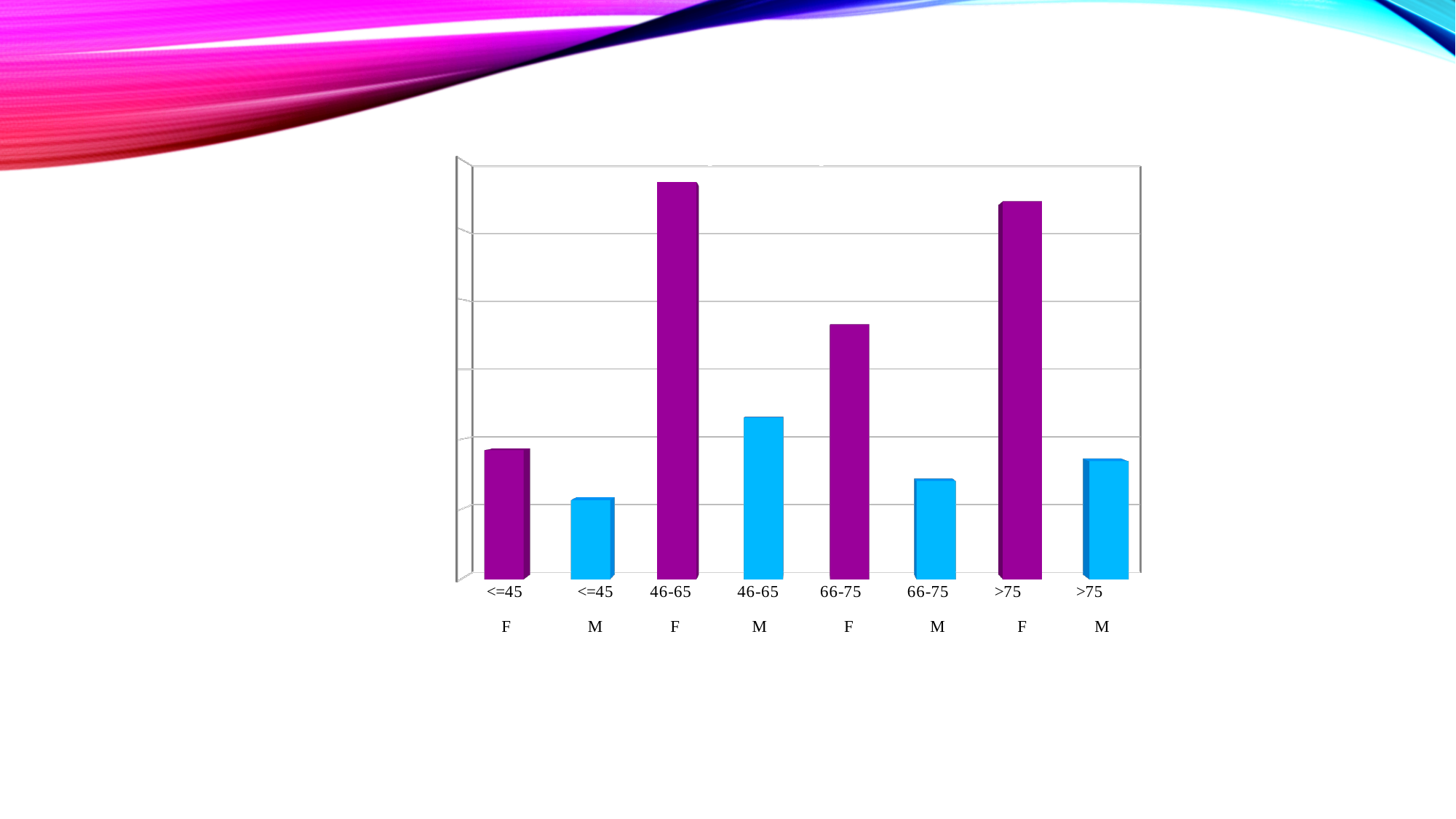
Which is larger, the bar for <=45 F or the bar for <=45 M? <=45 F Which is larger, the bar for >75 F or the bar for 66-75 F? >75 F How many bars are plotted in the chart? 8 Which bar is the tallest in the chart? 46-65 F What colour are the F bars in the chart? purple Among the F bars, which age group has the shortest bar? <=45 Which is larger, the bar for 46-65 M or the bar for >75 M? 46-65 M What kind of chart is shown on the slide? bar chart Among the M bars, which age group has the tallest bar? 46-65 Which bar is the shortest in the chart? <=45 M What colour are the M bars in the chart? blue